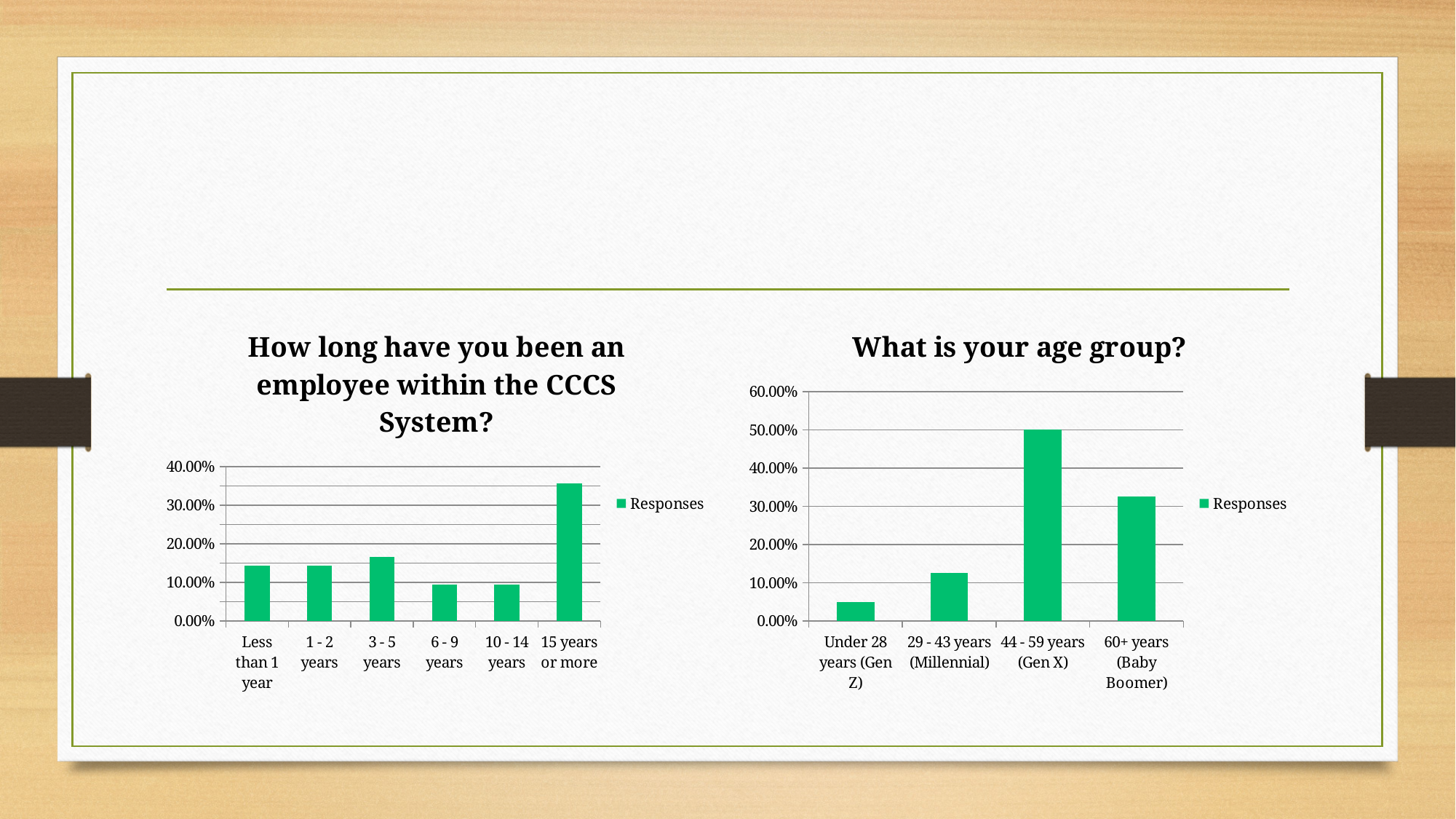
On the 'How long have you been an employee within the CCCS System?' chart, which category has the highest value? 15 years or more On the 'What is your age group?' chart, which category has the lowest value? Under 28 years (Gen Z) How many categories are shown on the 'How long have you been an employee within the CCCS System?' chart? 6 What is the name of the series shown in the legend of the 'How long have you been an employee within the CCCS System?' chart? Responses How many categories are shown on the 'What is your age group?' chart? 4 On the 'What is your age group?' chart, which is larger: the value for '29 - 43 years (Millennial)' or the value for '60+ years (Baby Boomer)'? 60+ years (Baby Boomer) On the 'What is your age group?' chart, which category has the highest value? 44 - 59 years (Gen X) On the 'How long have you been an employee within the CCCS System?' chart, is the value for '15 years or more' greater or less than 30.00%? greater How many series does the legend list on the 'What is your age group?' chart? 1 What kind of chart is the 'What is your age group?' chart? bar chart On the 'What is your age group?' chart, is the value for '60+ years (Baby Boomer)' greater or less than 30.00%? greater